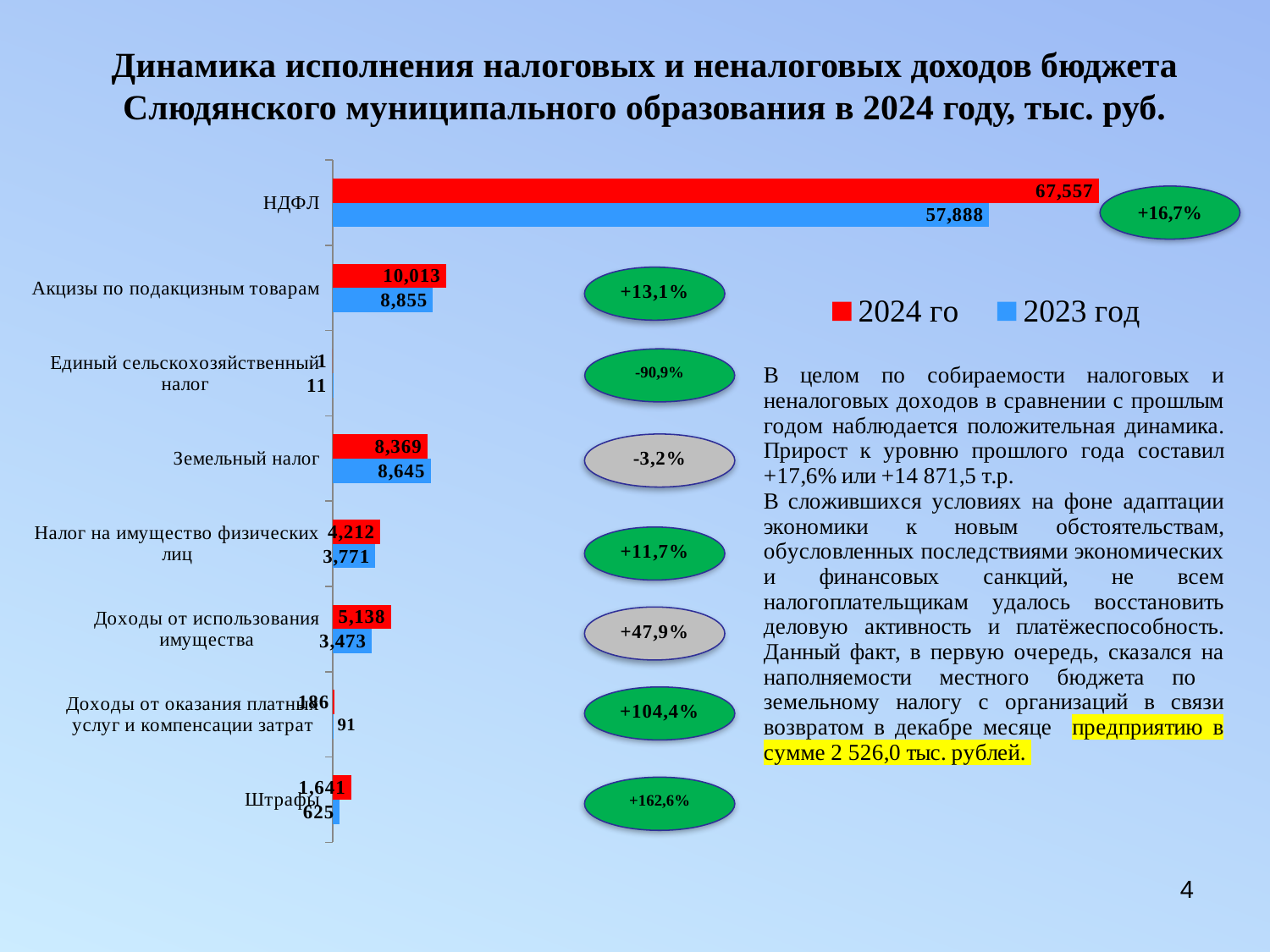
What kind of chart is shown on the slide? bar chart What is the difference between the 2024 год and 2023 год values for НДФЛ? 9,669 What is the value for НДФЛ in the 2023 год series? 57,888 What is the difference between the 2024 год and 2023 год values for Акцизы по подакцизным товарам? 1,158 What is the 2024 год value for Земельный налог? 8,369 How many series does the legend list? 2 How many categories are shown on the chart? 8 What is the value for НДФЛ in the 2024 год series? 67,557 For Земельный налог, which series has the larger value, 2024 год or 2023 год? 2023 год What is the 2023 год value for Единый сельскохозяйственный налог? 11 Which category has the highest value in the 2024 год series? НДФЛ What is the 2023 год value for Акцизы по подакцизным товарам? 8,855